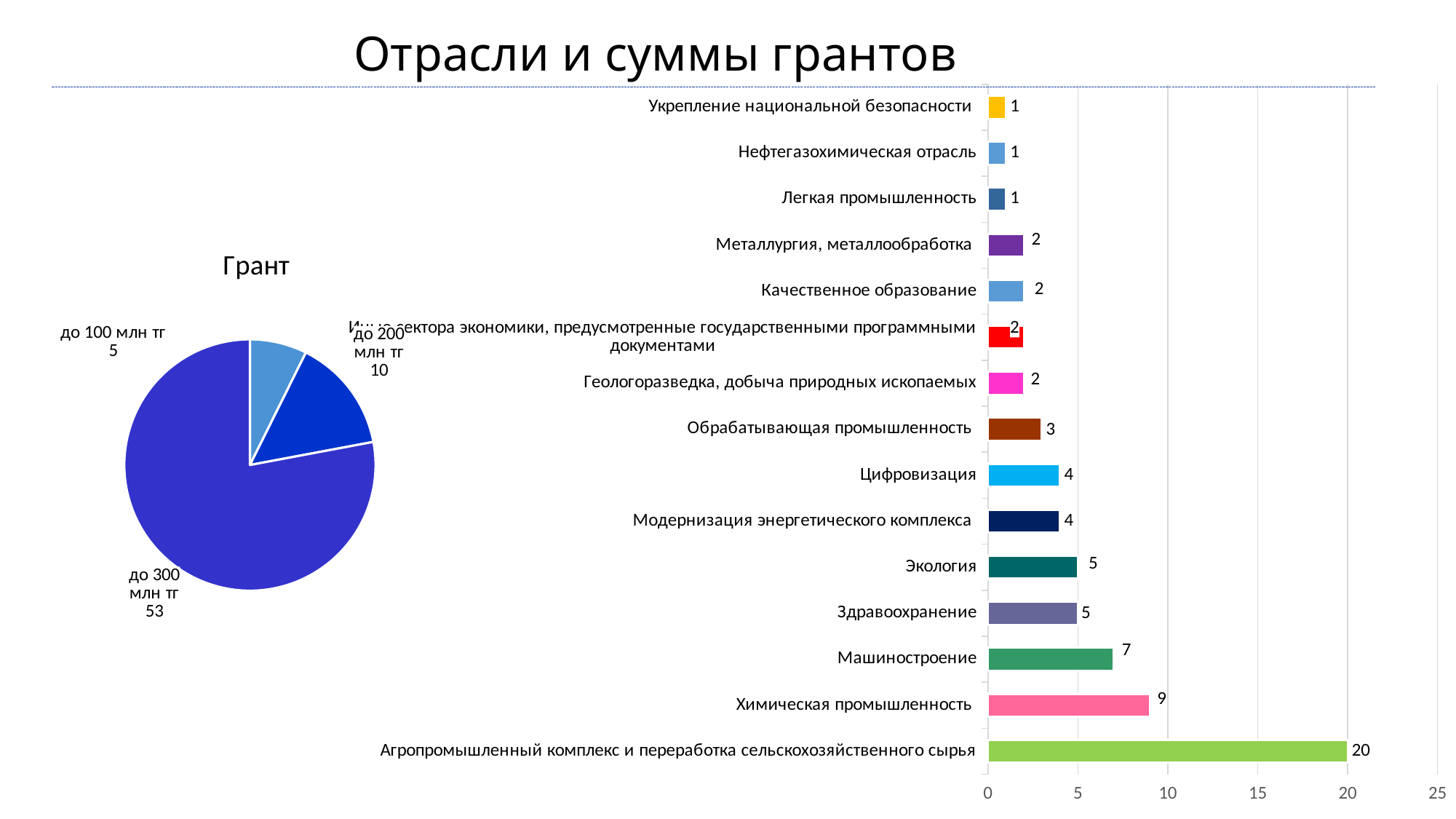
In the pie chart titled Грант, what is the value for до 300 млн тг? 53 In the bar chart on the right, how many categories are shown? 15 In the bar chart on the right, what is the difference between the values for Машиностроение and Здравоохранение? 2 What is the title of the pie chart on the left? Грант In the pie chart titled Грант, what is the value for до 100 млн тг? 5 In the bar chart on the right, what is the value for Химическая промышленность? 9 What kind of chart is the chart on the right of the slide? Bar chart In the pie chart titled Грант, which slice is the largest? до 300 млн тг In the bar chart on the right, which is larger: the value for Цифровизация or the value for Экология? Экология In the bar chart on the right, what is the value for Агропромышленный комплекс и переработка сельскохозяйственного сырья? 20 In the bar chart on the right, which category has the highest value? Агропромышленный комплекс и переработка сельскохозяйственного сырья In the bar chart on the right, what is the value for Обрабатывающая промышленность? 3